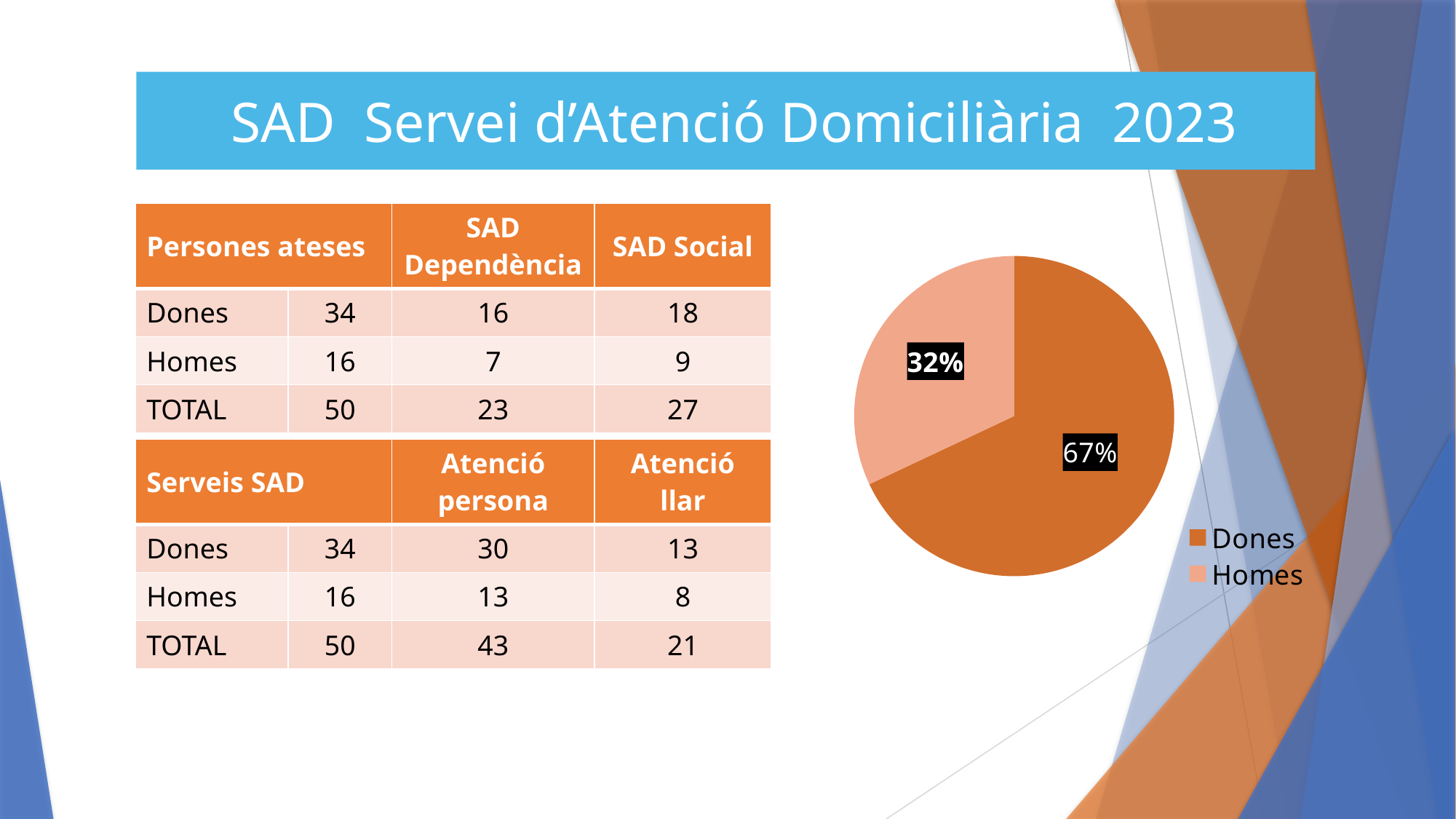
Which legend entry of the pie chart is shown in the darker orange colour? Dones In the pie chart, what share is labelled for Homes? 32% Which slice of the pie chart is the largest? Dones How many slices does the pie chart have? 2 In the pie chart, which is larger, the Dones slice or the Homes slice? Dones By how many percentage points does the Dones share exceed the Homes share in the pie chart? 35 percentage points Which slice of the pie chart is the smallest? Homes What kind of chart is shown on the right of the slide? pie chart How many entries does the pie chart's legend list? 2 What are the two legend entries of the pie chart? Dones and Homes In the pie chart, what share is labelled for Dones? 67%